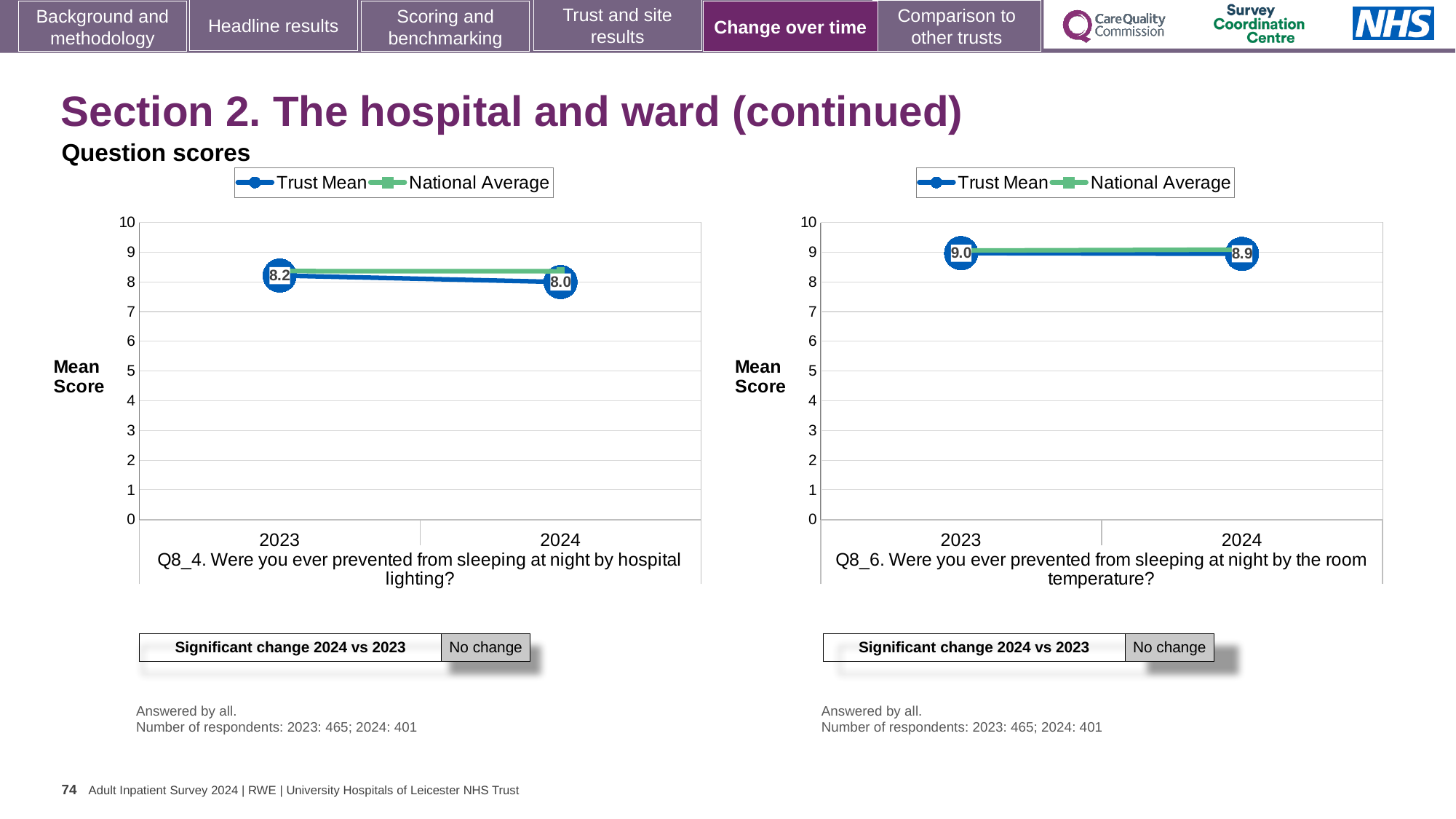
In the Q8_6 chart (right), which year has the higher Trust Mean? 2023 In the Q8_6 chart (right), what is the Trust Mean for 2023? 9.0 In the Q8_4 chart (left), what is the Trust Mean for 2024? 8.0 How many series does the legend of the Q8_6 chart (right) list? 2 How many years are plotted on the x axis of the Q8_4 chart (left)? 2 In the Q8_4 chart (left), what is the Trust Mean for 2023? 8.2 In the Q8_6 chart (right), what is the Trust Mean for 2024? 8.9 In the Q8_6 chart (right), what is the difference between the Trust Mean in 2023 and 2024? 0.1 In the Q8_4 chart (left), by how much did the Trust Mean change from 2023 to 2024? 0.2 In the Q8_4 chart (left), does the Trust Mean rise or fall from 2023 to 2024? fall In the Q8_4 chart (left), is the National Average for 2023 greater or less than 8? greater What kind of chart is the Q8_4 chart on the left? line chart